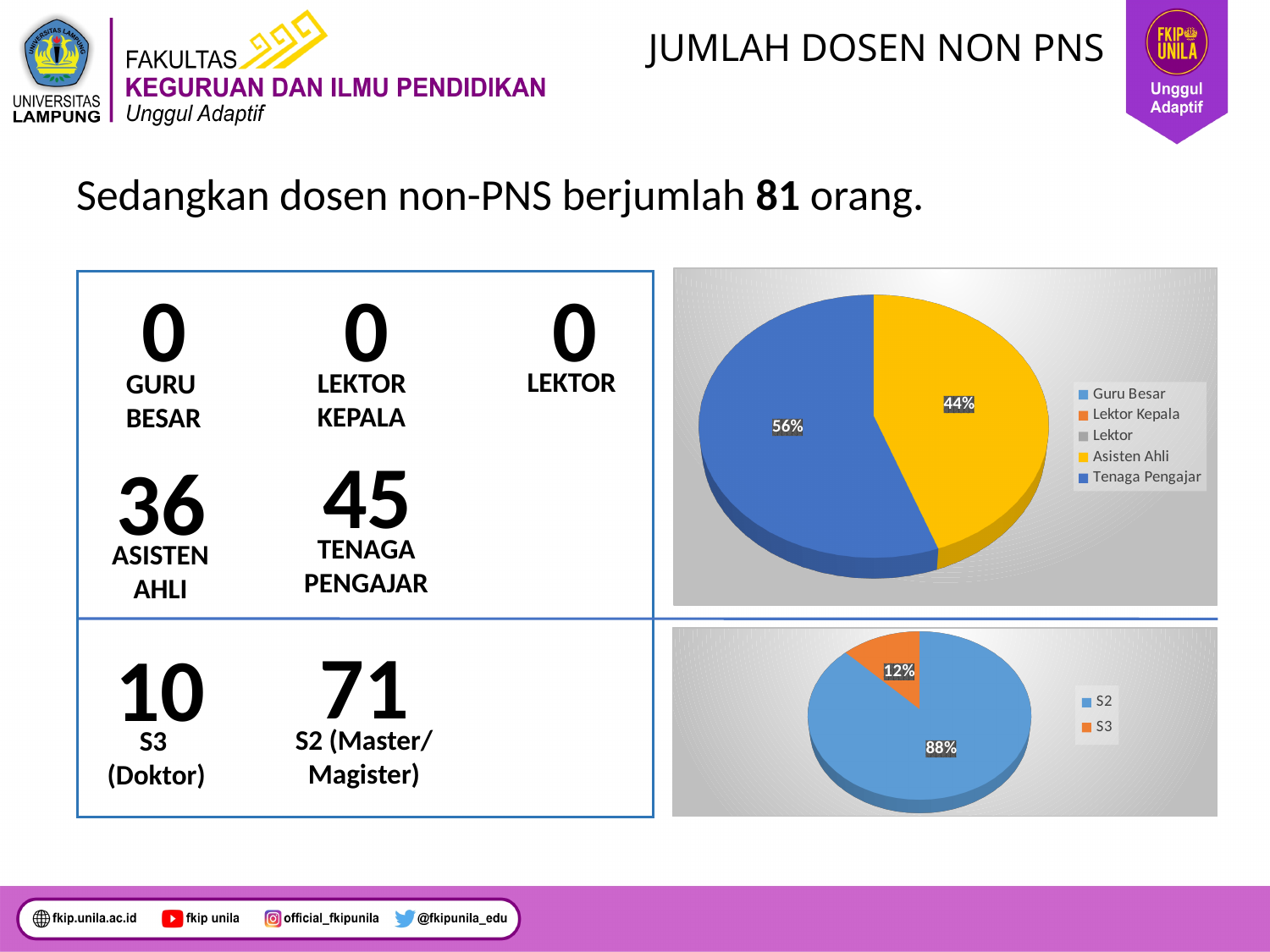
In the bottom pie chart, which category has the smaller slice? S3 In the bottom pie chart, how many entries does the legend list? 2 In the bottom pie chart, what share is labelled for S2? 88% In the top pie chart, what share is labelled for the Tenaga Pengajar slice? 56% In the bottom pie chart, is the S2 slice larger or smaller than the S3 slice? Larger In the top pie chart, how many entries does the legend list? 5 What kind of chart is the top chart on the slide? Pie chart In the bottom pie chart, what colour is the S3 slice? Orange In the top pie chart, what is the difference in percentage points between the Tenaga Pengajar and Asisten Ahli slices? 12 In the bottom pie chart, what share is labelled for S3? 12% In the top pie chart, which category has the largest slice? Tenaga Pengajar